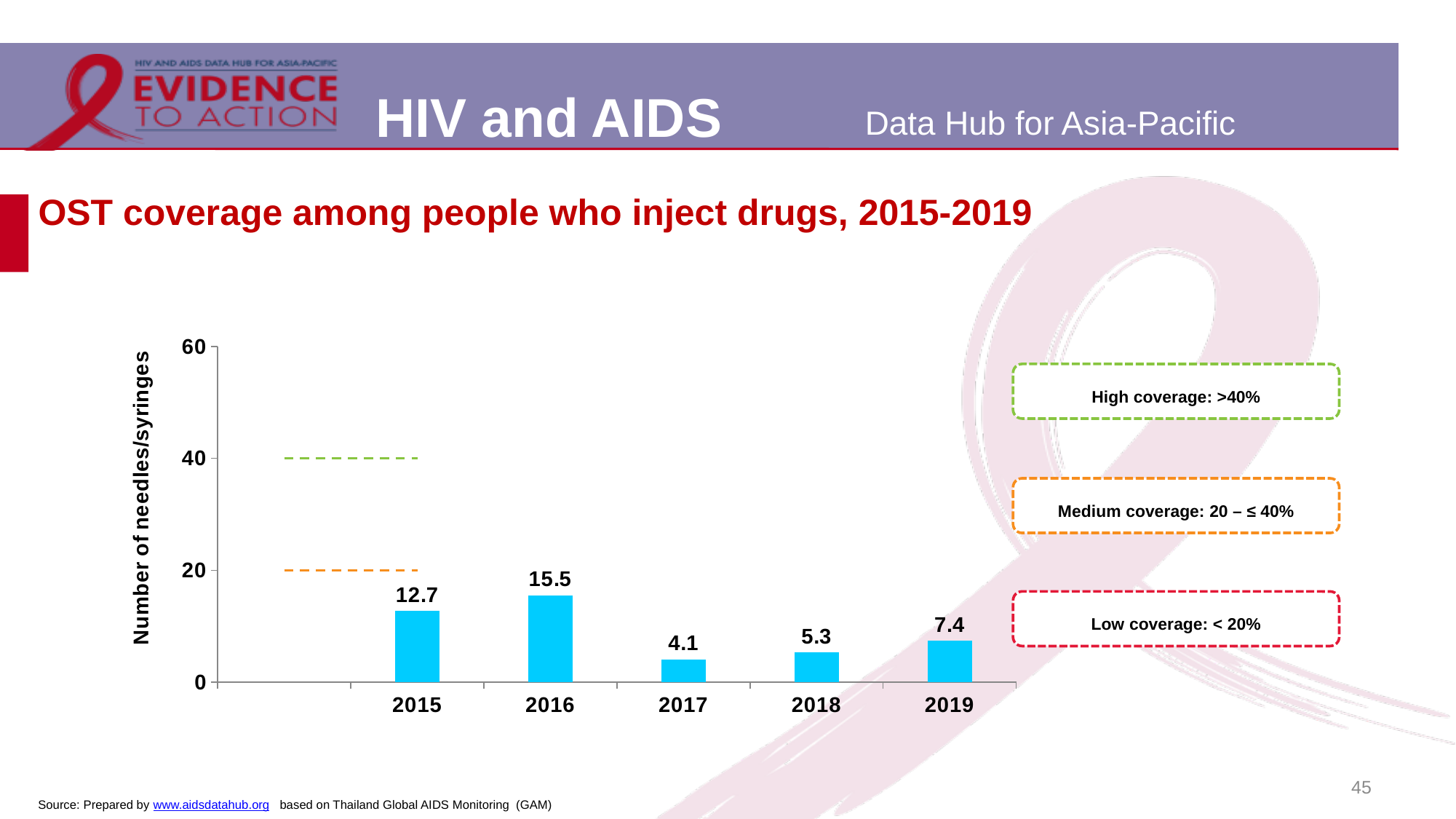
Which year has the highest value? 2016 How many years are shown on the x axis? 5 What kind of chart is shown on the slide? bar chart Is the value for 2016 greater or less than 20? less Which is larger, the value for 2018 or the value for 2017? 2018 What is the difference between the values for 2016 and 2015? 2.8 What is the difference between the values for 2019 and 2018? 2.1 What is the value for 2019? 7.4 What is the value for 2015? 12.7 What is the y-axis label of the chart? Number of needles/syringes What is the value for 2017? 4.1 Which year has the lowest value? 2017